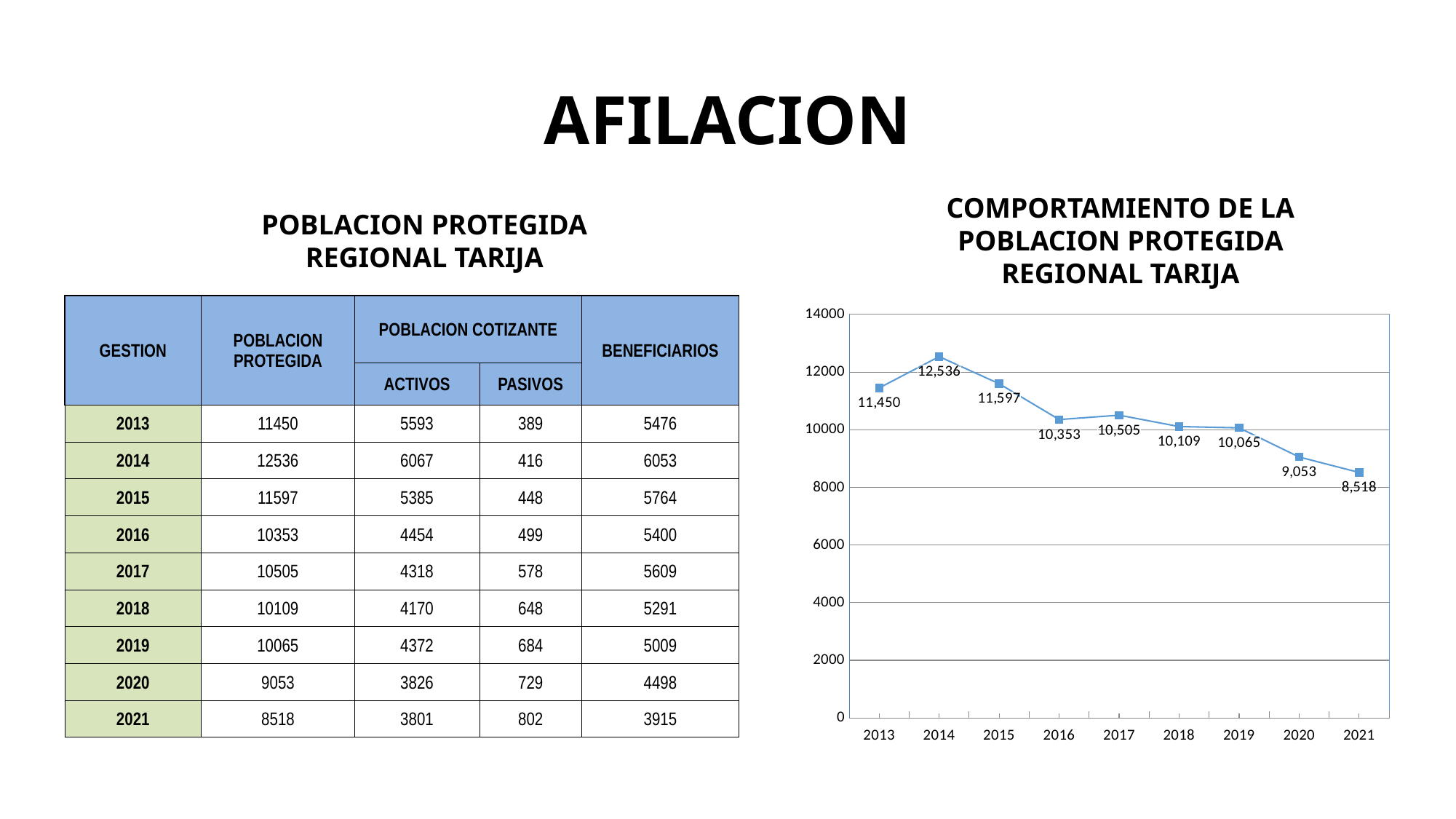
Which year has the lowest value in the line chart? 2021 What is the title of the line chart? COMPORTAMIENTO DE LA POBLACION PROTEGIDA REGIONAL TARIJA What type of chart is shown on the slide? Line chart Is the value for 2020 in the line chart greater or less than 10000? less Which year has the highest value in the line chart? 2014 What is the difference between the values for 2013 and 2015 in the line chart? 147 What is the value plotted for 2014 in the line chart? 12,536 What is the value plotted for 2021 in the line chart? 8,518 What is the difference between the values for 2014 and 2021 in the line chart? 4,018 How many years are plotted on the x axis of the line chart? 9 Which is larger in the line chart, the value for 2016 or the value for 2017? 2017 What is the value plotted for 2017 in the line chart? 10,505